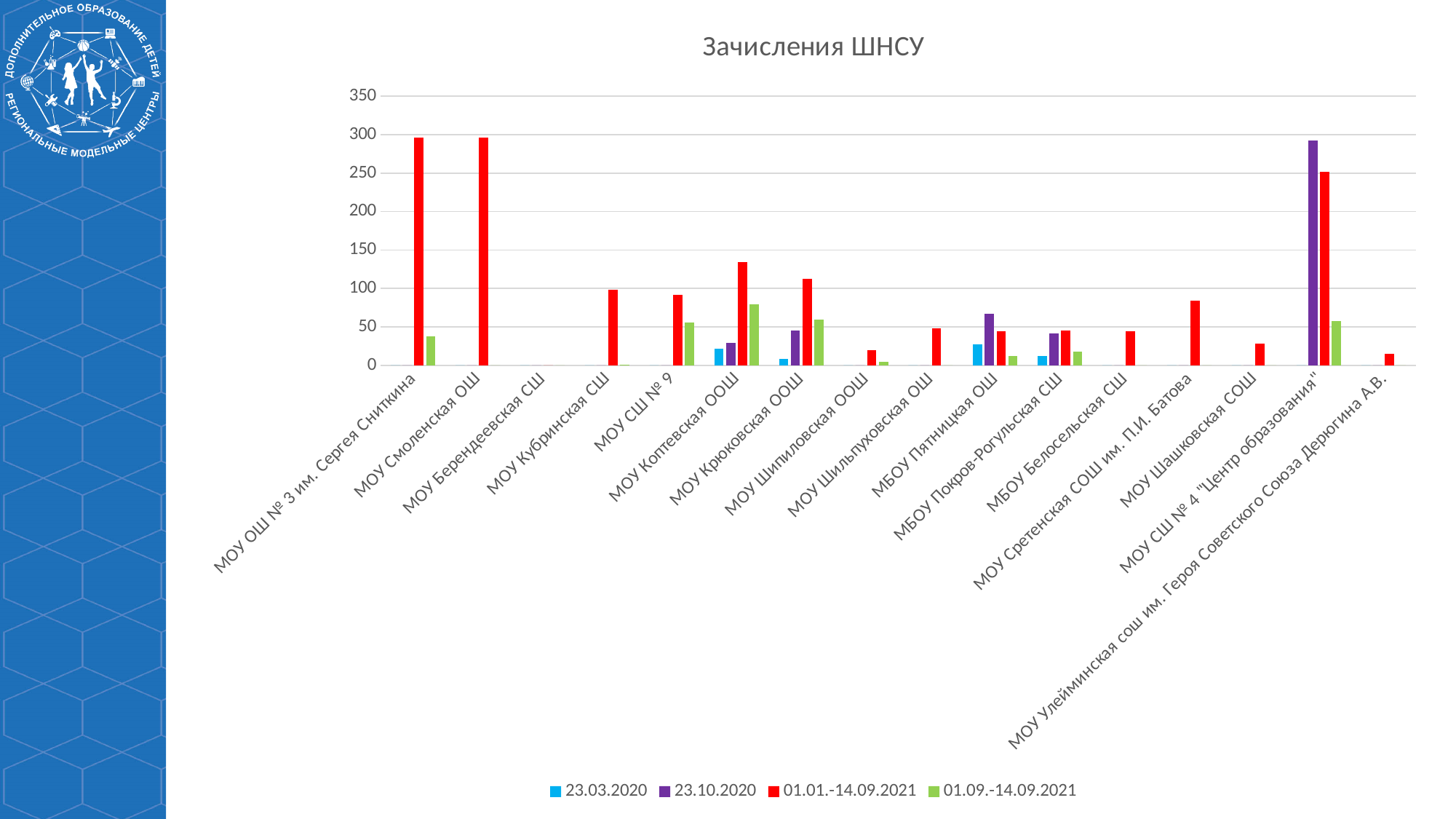
Is the 01.01.-14.09.2021 value for МОУ Сретенская СОШ им. П.И. Батова greater or less than 100? less How many series does the legend list? 4 Which series is shown in red in the legend? 01.01.-14.09.2021 Is the 01.01.-14.09.2021 value for МОУ Шашковская СОШ greater or less than 50? less How many schools (categories) are shown on the x axis? 16 What is the title of the chart? Зачисления ШНСУ Which school has the highest 01.09.-14.09.2021 value? МОУ Коптевская ООШ Is the 23.10.2020 value for МОУ СШ № 4 "Центр образования" greater or less than 250? greater Which is larger, the 01.01.-14.09.2021 value for МОУ Коптевская ООШ or for МОУ Крюковская ООШ? МОУ Коптевская ООШ What kind of chart is shown on the slide? bar chart Which school has the highest 23.10.2020 value? МОУ СШ № 4 "Центр образования"